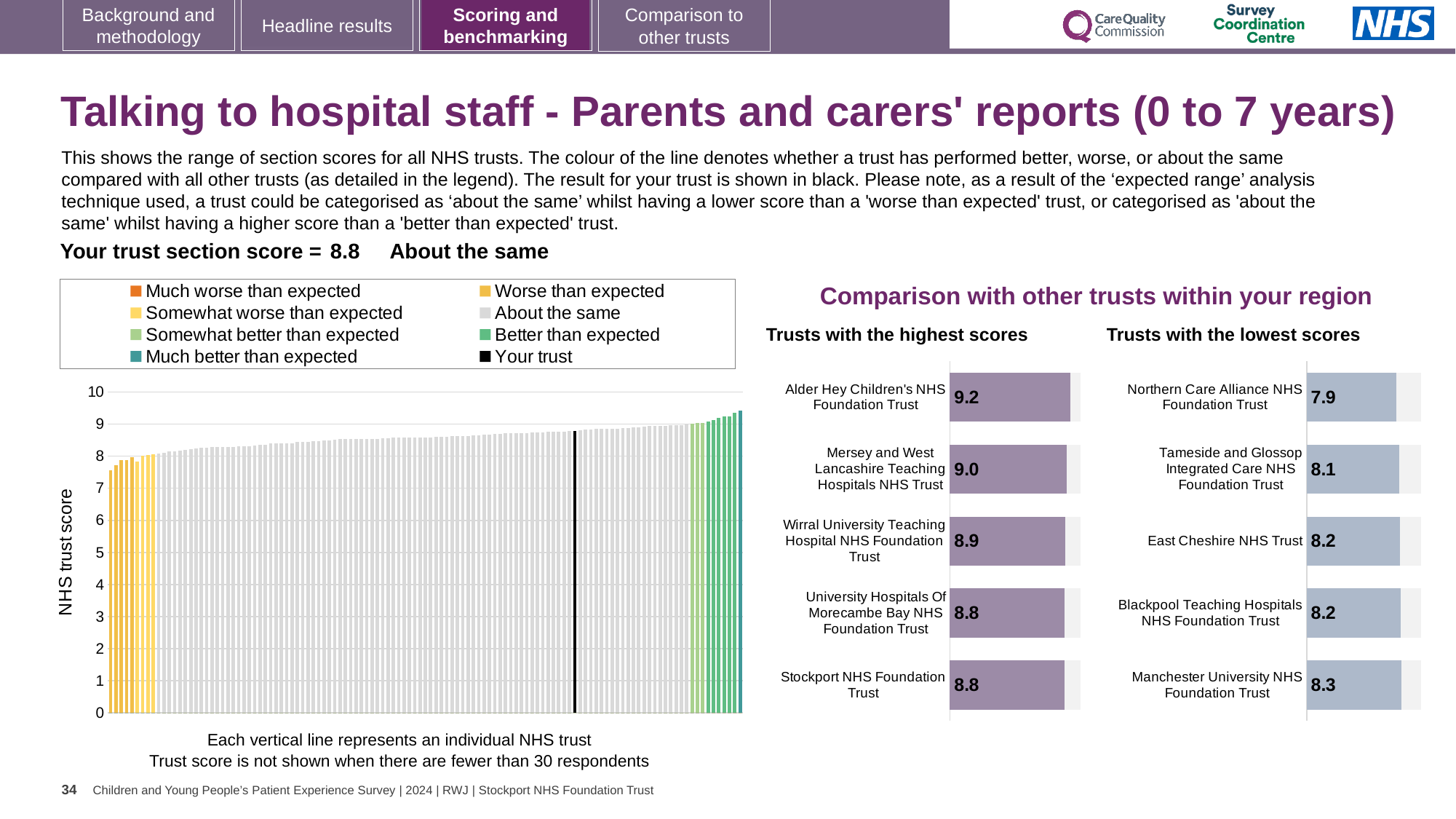
In the 'Trusts with the lowest scores' chart, which trust has the highest score? Manchester University NHS Foundation Trust In the 'Trusts with the highest scores' chart, what is the difference between the scores of Alder Hey Children's NHS Foundation Trust and Stockport NHS Foundation Trust? 0.4 In the 'Trusts with the highest scores' chart, what is the score for Alder Hey Children's NHS Foundation Trust? 9.2 In the 'Trusts with the lowest scores' chart, which trust has the lowest score? Northern Care Alliance NHS Foundation Trust In the 'Trusts with the lowest scores' chart, which has the larger score: Tameside and Glossop Integrated Care NHS Foundation Trust or East Cheshire NHS Trust? East Cheshire NHS Trust In the large chart on the left, is the value for the black 'Your trust' line greater or less than 8? greater What kind of chart is the large chart on the left of the slide? bar chart How many entries does the legend above the large chart on the left list? 8 In the large chart on the left, do the trust scores rise or fall from left to right? rise In the 'Trusts with the highest scores' chart, what is the score for Wirral University Teaching Hospital NHS Foundation Trust? 8.9 In the 'Trusts with the lowest scores' chart, what is the score for Northern Care Alliance NHS Foundation Trust? 7.9 In the 'Trusts with the highest scores' chart, how many trusts are listed? 5